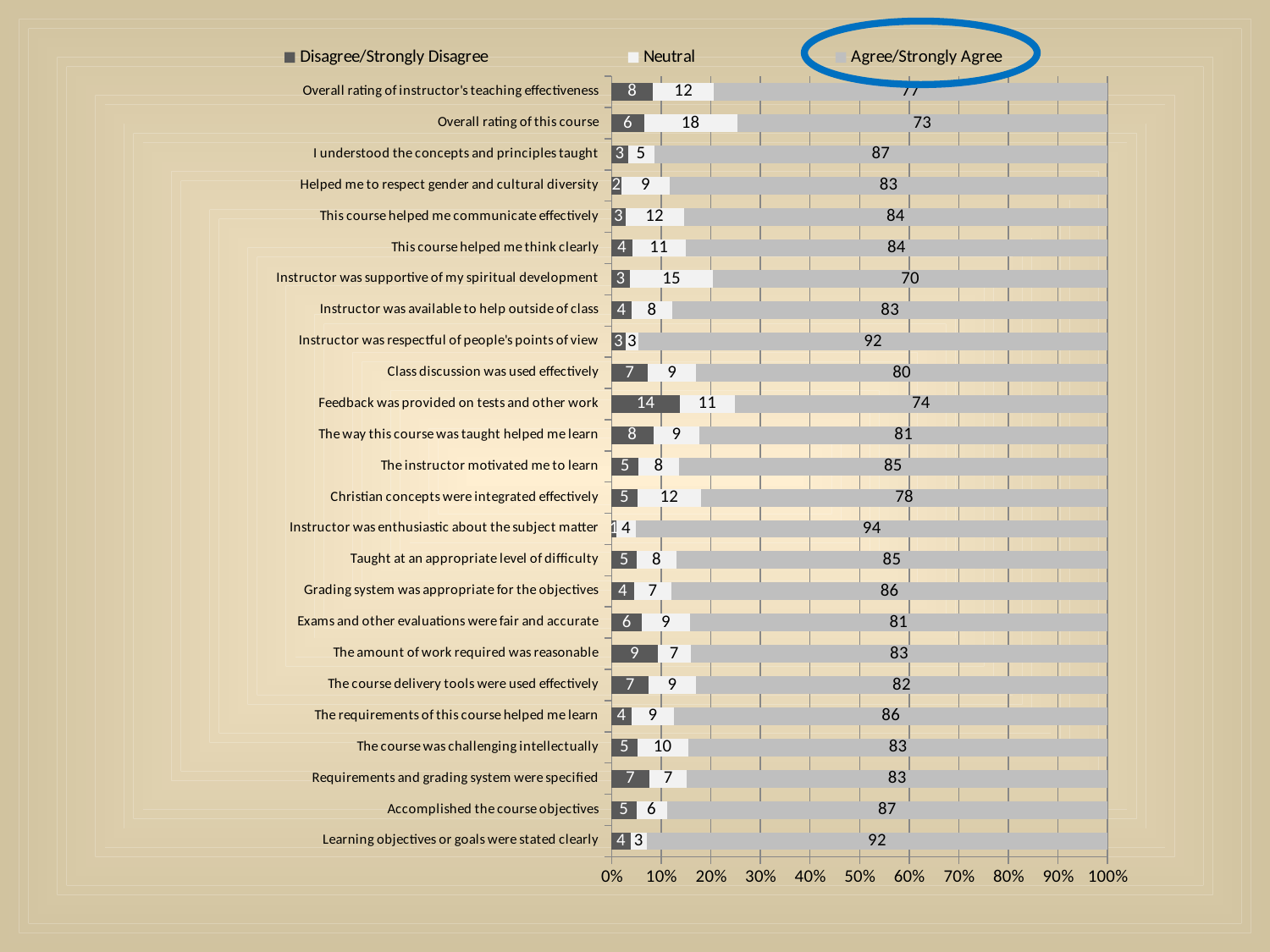
What is the total of the three printed values for "Overall rating of this course"? 97 Which statement has the lowest Agree/Strongly Agree value? Instructor was supportive of my spiritual development How many statements (categories) are plotted in the chart? 25 Which statement has the highest Disagree/Strongly Disagree value? Feedback was provided on tests and other work Which statement has the highest Agree/Strongly Agree value? Instructor was enthusiastic about the subject matter What kind of chart is shown on the slide? Stacked bar chart What is the difference between the Agree/Strongly Agree values for "Instructor was respectful of people's points of view" and "Class discussion was used effectively"? 12 What is the Disagree/Strongly Disagree value for "Feedback was provided on tests and other work"? 14 What is the Agree/Strongly Agree value for "Instructor was enthusiastic about the subject matter"? 94 What is the Neutral value for "Overall rating of this course"? 18 Which has a larger Agree/Strongly Agree value: "Christian concepts were integrated effectively" or "The instructor motivated me to learn"? The instructor motivated me to learn How many series does the legend list? 3